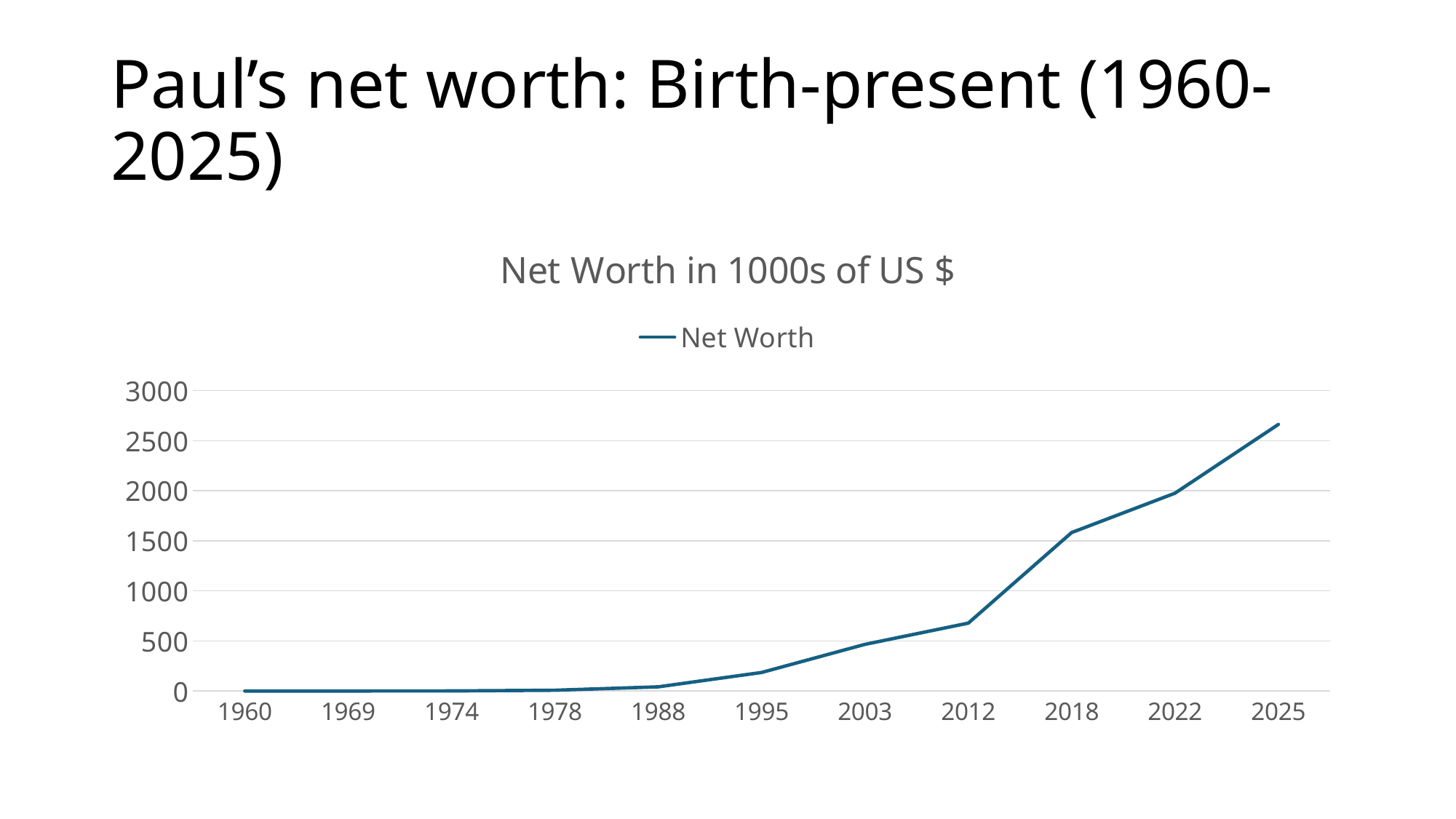
What kind of chart is shown on the slide? line chart What is the name of the series shown in the legend? Net Worth In which year is Net Worth highest? 2025 Is the Net Worth value for 2025 greater or less than 2500? greater Is the Net Worth value for 2012 greater or less than 500? greater Is the Net Worth value for 1995 greater or less than 500? less How many series does the legend list? 1 Which year has the larger Net Worth value, 2012 or 2018? 2018 Do the Net Worth values generally rise or fall from 1960 to 2025? rise How many years are labelled along the x axis? 11 What is the title of the chart? Net Worth in 1000s of US $